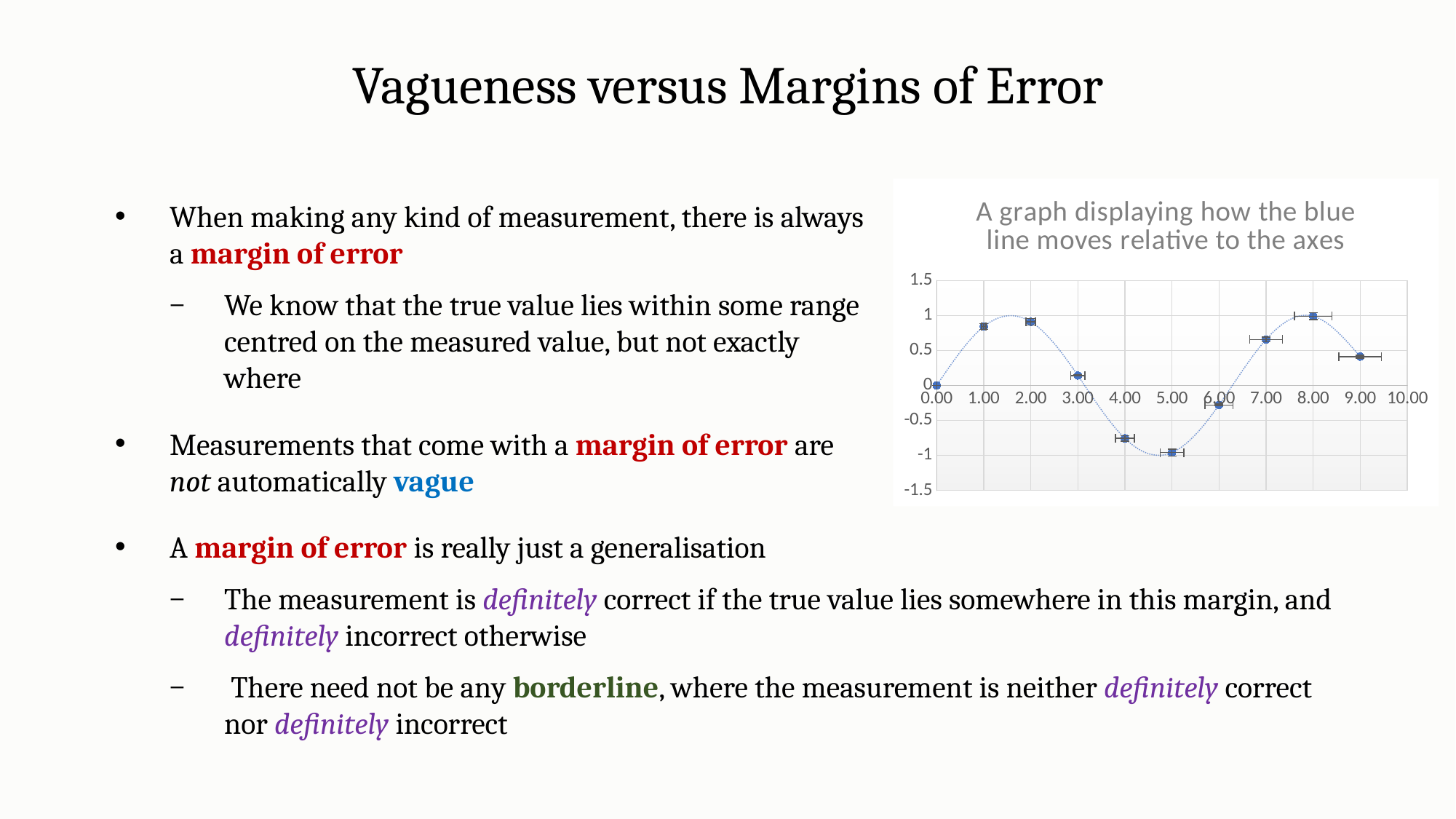
Is the value at x = 3.00 greater or less than 0.5? less Which x value has the lowest plotted point? 5.00 Is the value at x = 4.00 greater or less than -0.5? less How many data points are plotted on the chart? 10 Do the plotted values rise or fall between x = 2.00 and x = 5.00? fall What is the title of the chart? A graph displaying how the blue line moves relative to the axes What is the highest value shown on the vertical axis? 1.5 Is the value at x = 8.00 greater or less than 0.5? greater Which is larger, the value at x = 7.00 or the value at x = 6.00? x = 7.00 Which is larger, the value at x = 1.00 or the value at x = 3.00? x = 1.00 What kind of chart is shown on the slide? Scatter chart with a dotted line